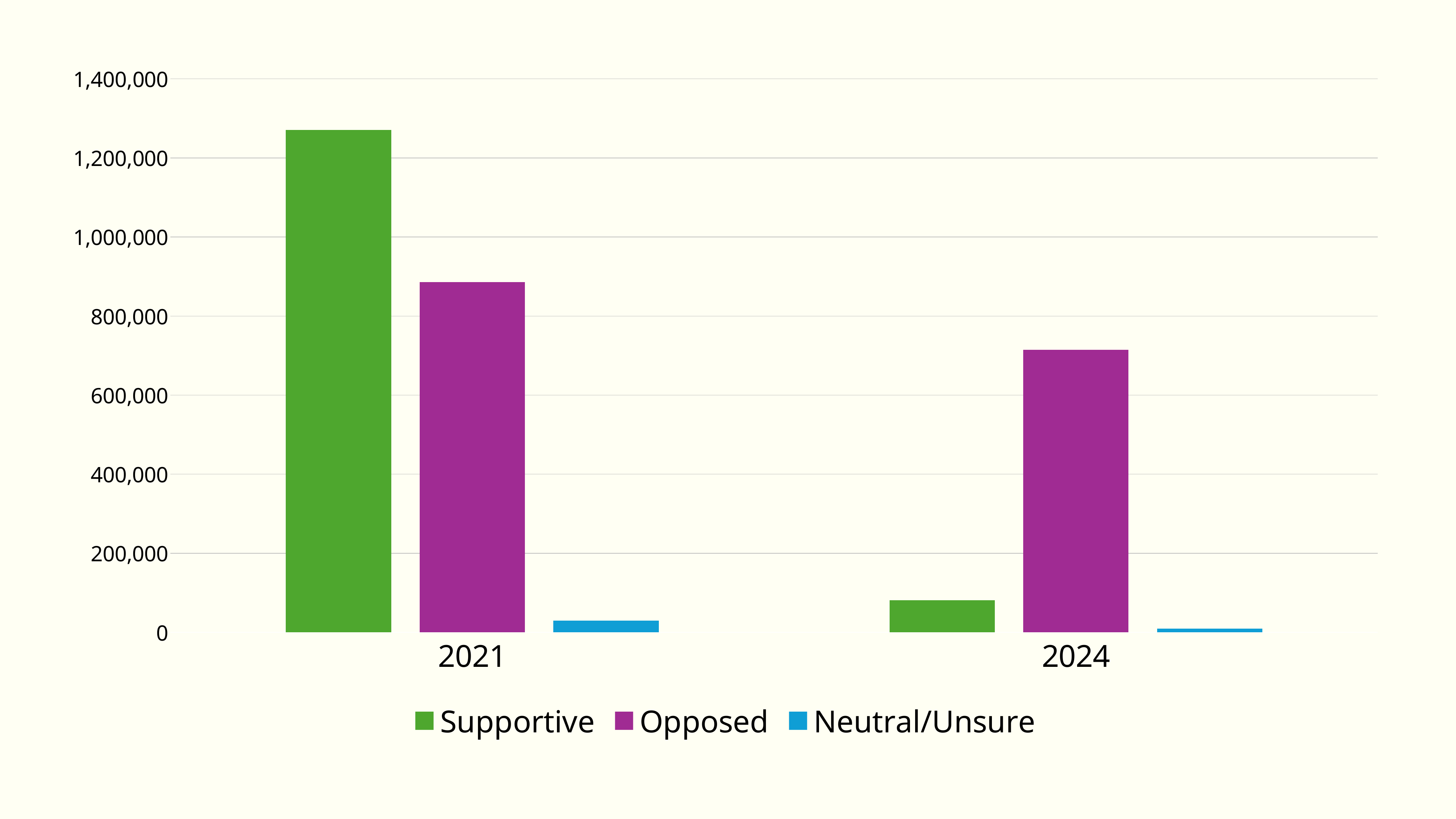
Does the Supportive series rise or fall from 2021 to 2024? fall What colour represents the Neutral/Unsure series? blue Is the value for Supportive in 2021 greater or less than 1,200,000? greater Which series has the highest value in 2024? Opposed Is the value for Supportive in 2024 greater or less than 200,000? less Which series has the highest value in 2021? Supportive Which series has the lowest value in 2024? Neutral/Unsure What kind of chart is shown on the slide? bar chart Which is larger, Opposed in 2021 or Opposed in 2024? Opposed in 2021 How many series does the legend list? 3 How many categories are shown on the x axis? 2 Is the value for Opposed in 2024 greater or less than 800,000? less